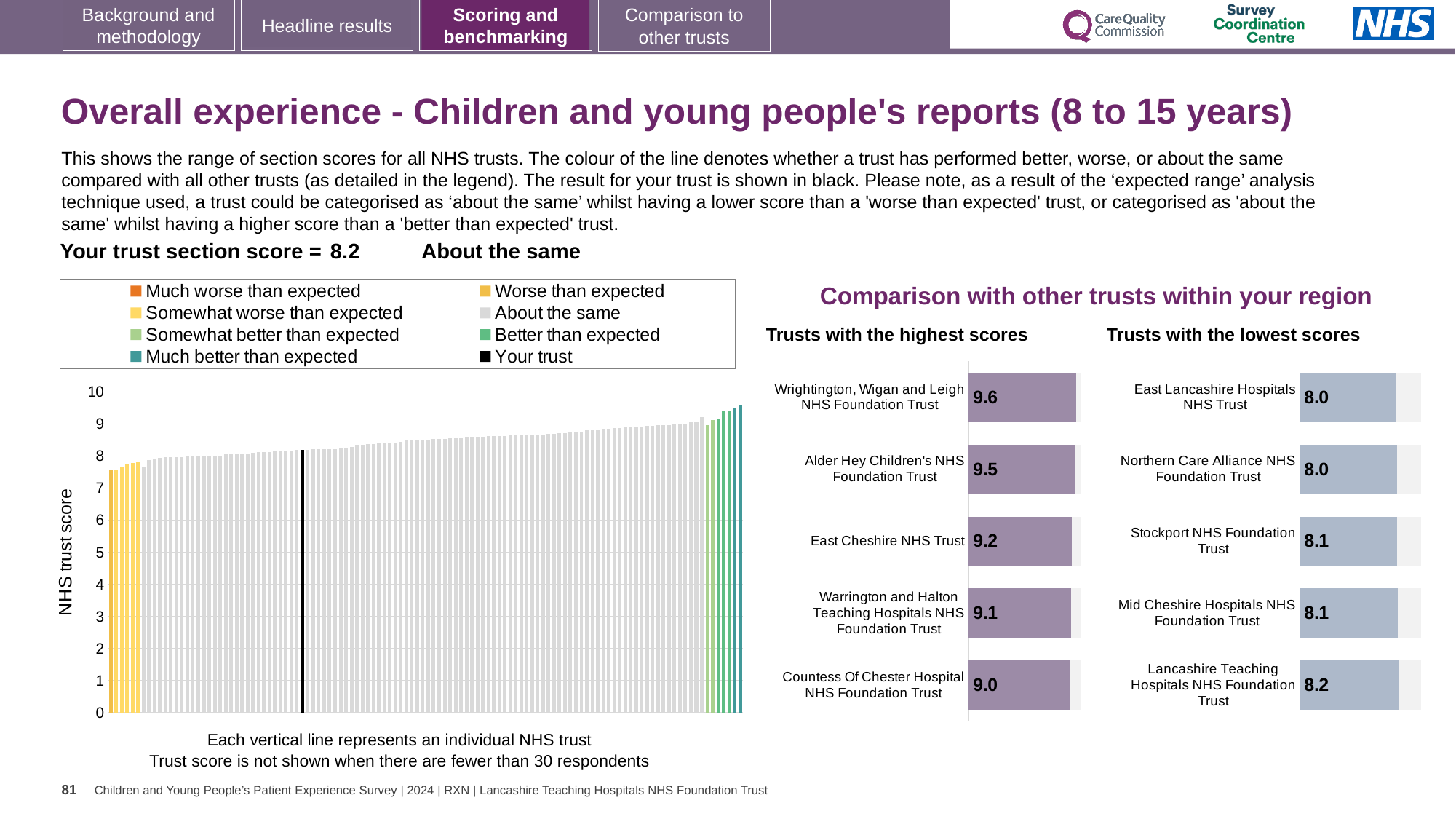
In the 'Trusts with the highest scores' chart, which has the higher score: Alder Hey Children's NHS Foundation Trust or East Cheshire NHS Trust? Alder Hey Children's NHS Foundation Trust What kind of chart is the large chart on the left showing all NHS trusts? bar chart How many trusts are shown in the 'Trusts with the lowest scores' chart? 5 In the 'Trusts with the highest scores' chart, what is the difference between the scores of Wrightington, Wigan and Leigh NHS Foundation Trust and Countess Of Chester Hospital NHS Foundation Trust? 0.6 In the 'Trusts with the highest scores' chart, which trust has the highest score? Wrightington, Wigan and Leigh NHS Foundation Trust In the 'Trusts with the lowest scores' chart, which trust has the highest score? Lancashire Teaching Hospitals NHS Foundation Trust In the 'Trusts with the highest scores' chart, what is the score for Wrightington, Wigan and Leigh NHS Foundation Trust? 9.6 In the 'Trusts with the highest scores' chart, what is the score for Countess Of Chester Hospital NHS Foundation Trust? 9.0 In the 'Trusts with the lowest scores' chart, what is the difference between the scores of Lancashire Teaching Hospitals NHS Foundation Trust and East Lancashire Hospitals NHS Trust? 0.2 How many entries does the legend of the large chart on the left list? 8 In the 'Trusts with the lowest scores' chart, what is the score for Stockport NHS Foundation Trust? 8.1 In the large chart on the left showing all NHS trusts, is the value of the lowest bar greater or less than 8? less